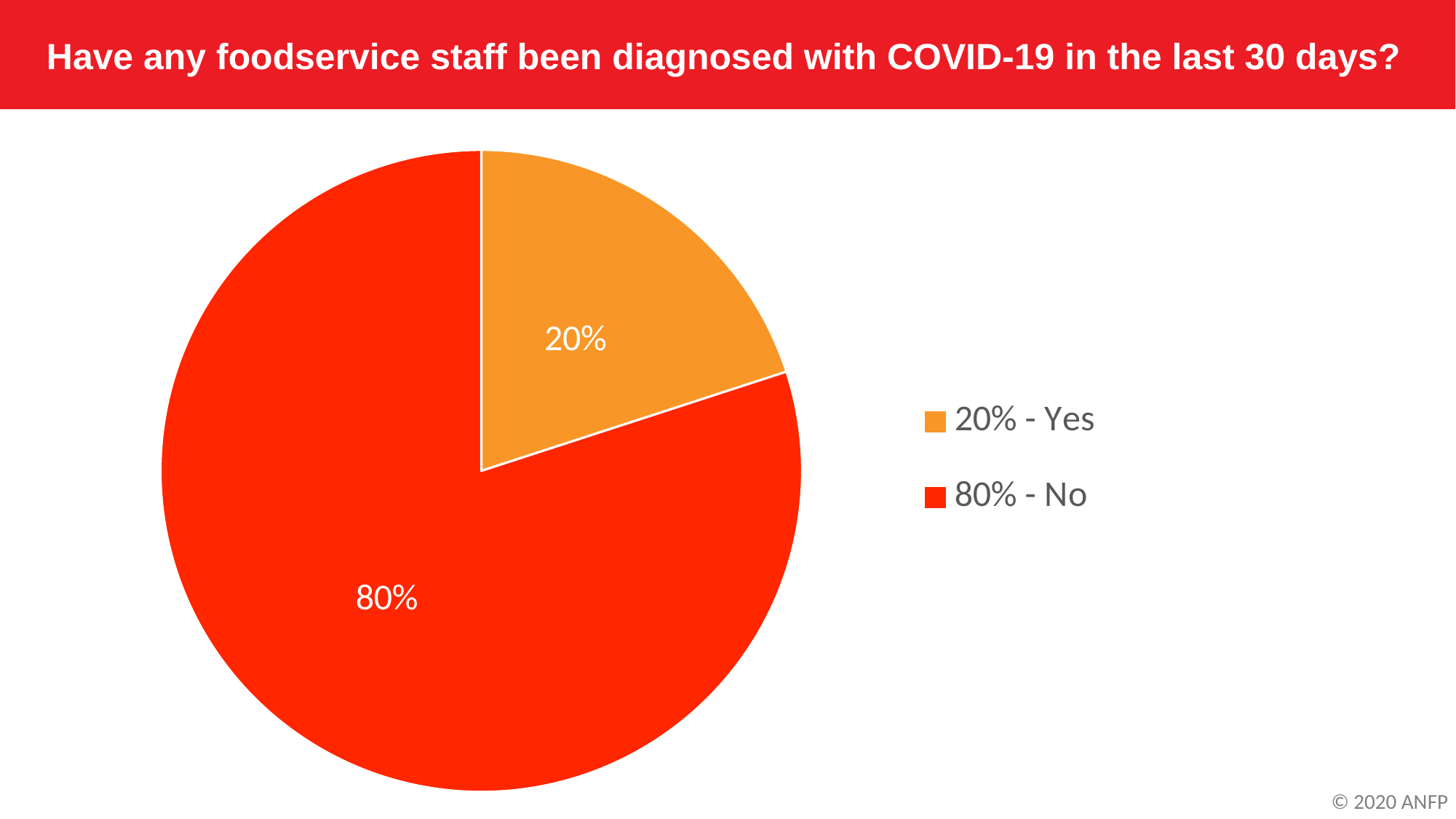
What is the difference in percentage points between the No and Yes slices? 60 What kind of chart is shown on the slide? pie chart What is the title of the chart? Have any foodservice staff been diagnosed with COVID-19 in the last 30 days? What colour is the slice for Yes? orange Which response has the smallest slice of the pie? Yes What share of the pie does the No slice represent? 80% What share of respondents answered No? 80% How many entries does the legend list? 2 Which slice is larger, Yes or No? No How many slices does the pie chart have? 2 What share of respondents answered Yes? 20% Which response has the largest slice of the pie? No